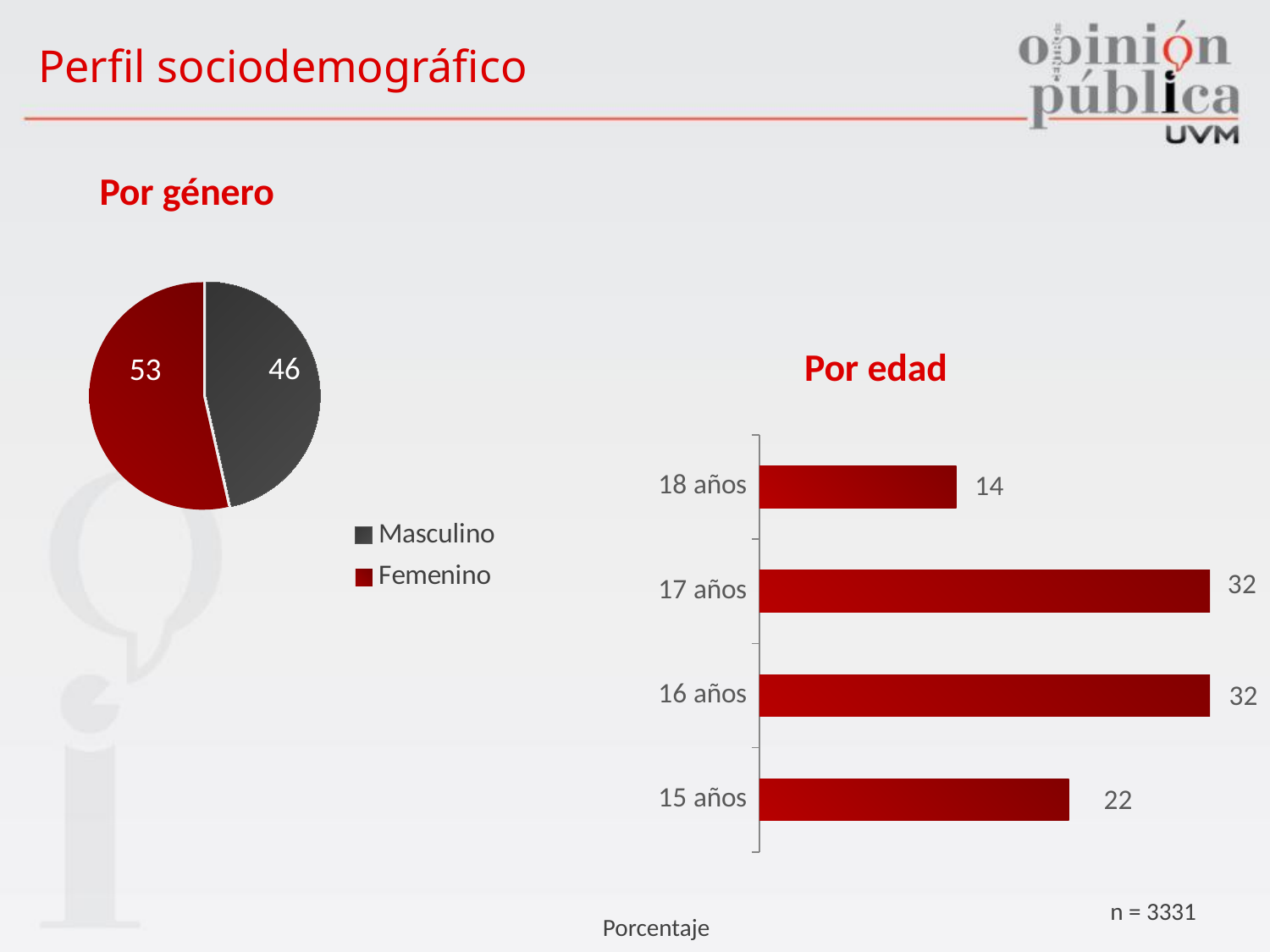
How many age categories are shown in the 'Por edad' chart? 4 In the 'Por género' pie chart, which category is larger, Masculino or Femenino? Femenino In the 'Por edad' chart, which age category has the lowest value? 18 años How many entries does the legend of the 'Por género' pie chart list? 2 In the 'Por edad' chart, what is the value for 15 años? 22 What kind of chart is the 'Por género' chart? Pie chart What kind of chart is the 'Por edad' chart? Bar chart In the 'Por género' pie chart, what is the value for Femenino? 53 In the 'Por género' pie chart, what is the value for Masculino? 46 In the 'Por edad' chart, what is the difference between the values for 16 años and 15 años? 10 In the 'Por género' pie chart, what is the difference between the Femenino and Masculino values? 7 In the 'Por edad' chart, what is the value for 18 años? 14